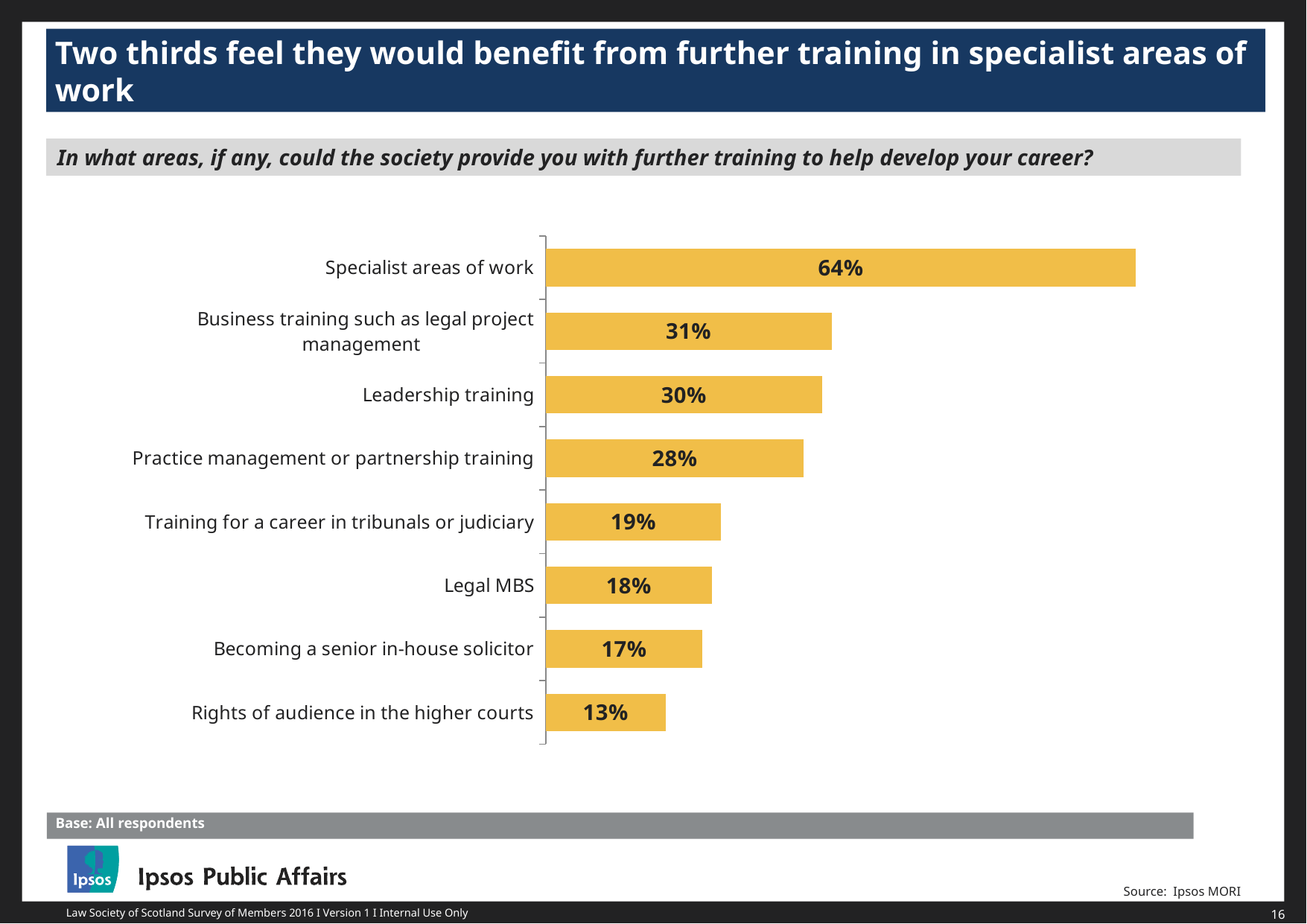
What kind of chart is shown on the slide? Bar chart What percentage of respondents said the society could provide further training in specialist areas of work? 64% What is the difference between the values for Specialist areas of work and Business training such as legal project management? 33 percentage points What is the value for Rights of audience in the higher courts? 13% What is the base for the chart, as stated on the slide? All respondents What is the value for Leadership training? 30% How many training areas are shown in the chart? 8 What is the difference between Practice management or partnership training and Training for a career in tribunals or judiciary? 9 percentage points What percentage is shown for Legal MBS? 18% Which training area has the lowest percentage? Rights of audience in the higher courts Which training area has the highest percentage? Specialist areas of work Which is larger: the value for Legal MBS or the value for Becoming a senior in-house solicitor? Legal MBS